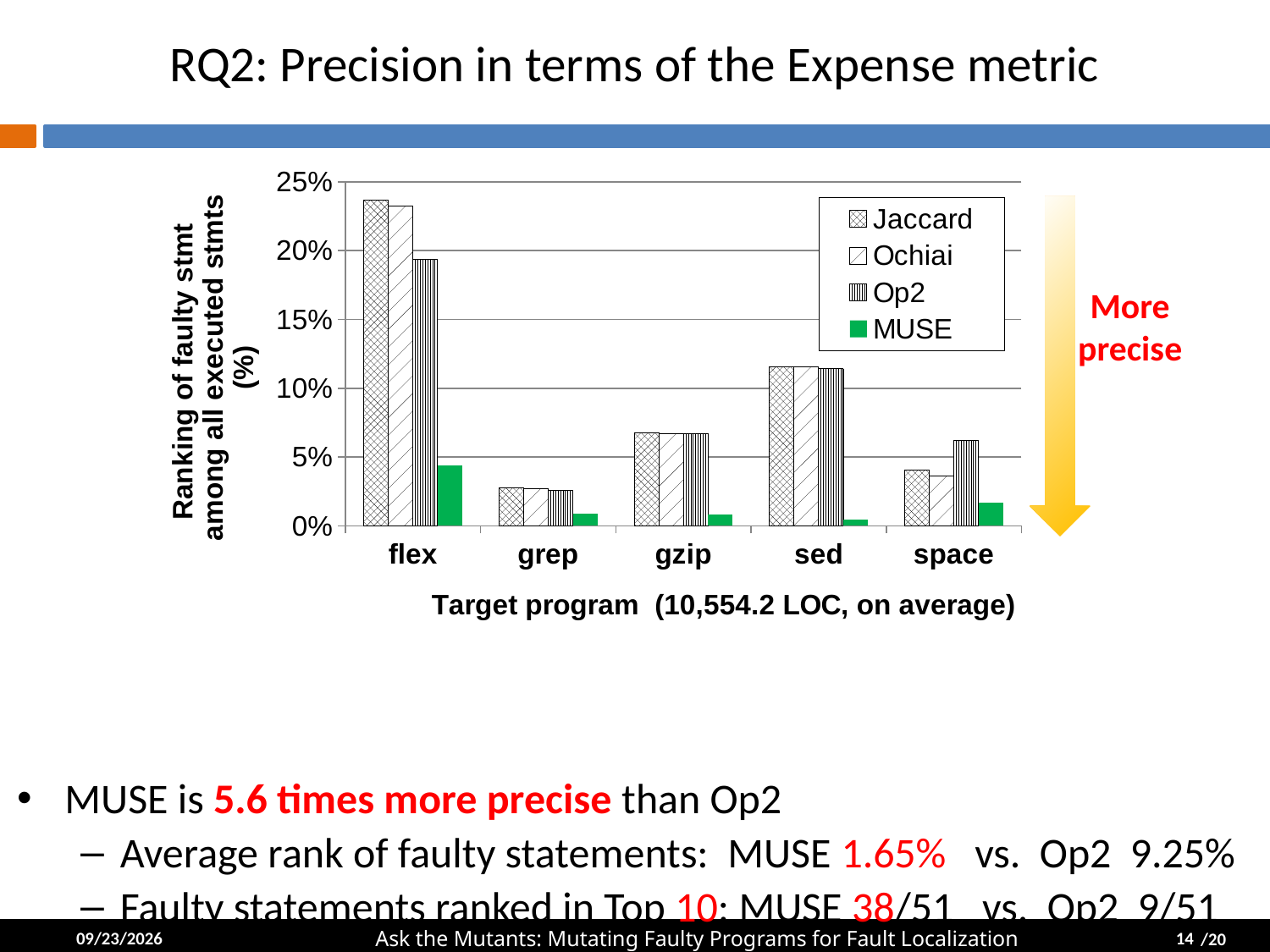
Is the Jaccard value for grep greater or less than 5%? less Is the MUSE value for flex greater or less than 5%? less What kind of chart is shown on the slide? bar chart For space, which is larger: the Op2 value or the Ochiai value? Op2 How many target programs are shown on the x axis of the chart? 5 Is the Jaccard value for sed greater or less than 10%? greater For which target program is the Jaccard value highest? flex How many series does the chart's legend list? 4 Which series are listed in the chart's legend? Jaccard, Ochiai, Op2, MUSE What is the x-axis title of the chart? Target program (10,554.2 LOC, on average)